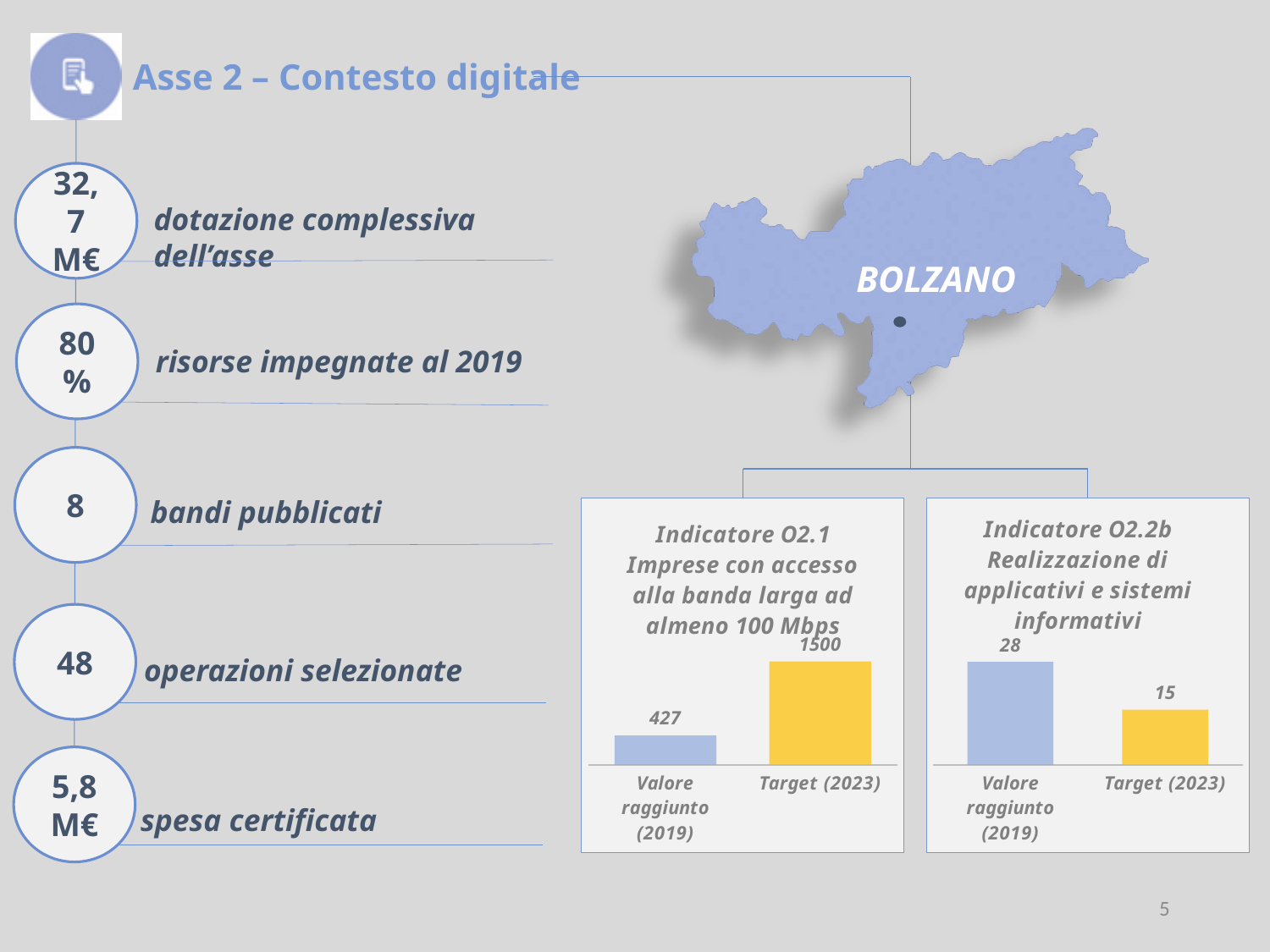
In the Indicatore O2.2b chart, is the value for Valore raggiunto (2019) larger or smaller than the value for Target (2023)? larger In the Indicatore O2.1 chart, what is the value for Valore raggiunto (2019)? 427 In the Indicatore O2.1 chart, what colour is the Target (2023) bar? yellow In the Indicatore O2.1 chart, what is the difference between Target (2023) and Valore raggiunto (2019)? 1073 In the Indicatore O2.2b chart, what is the value for Target (2023)? 15 What type of chart is used for Indicatore O2.2b? bar chart In the Indicatore O2.2b chart, what is the difference between Valore raggiunto (2019) and Target (2023)? 13 How many bars are shown in the Indicatore O2.1 chart? 2 In the Indicatore O2.2b chart, which category has the lower value? Target (2023) In the Indicatore O2.2b chart, what is the value for Valore raggiunto (2019)? 28 In the Indicatore O2.1 chart, what is the value for Target (2023)? 1500 In the Indicatore O2.1 chart, which category has the higher value? Target (2023)